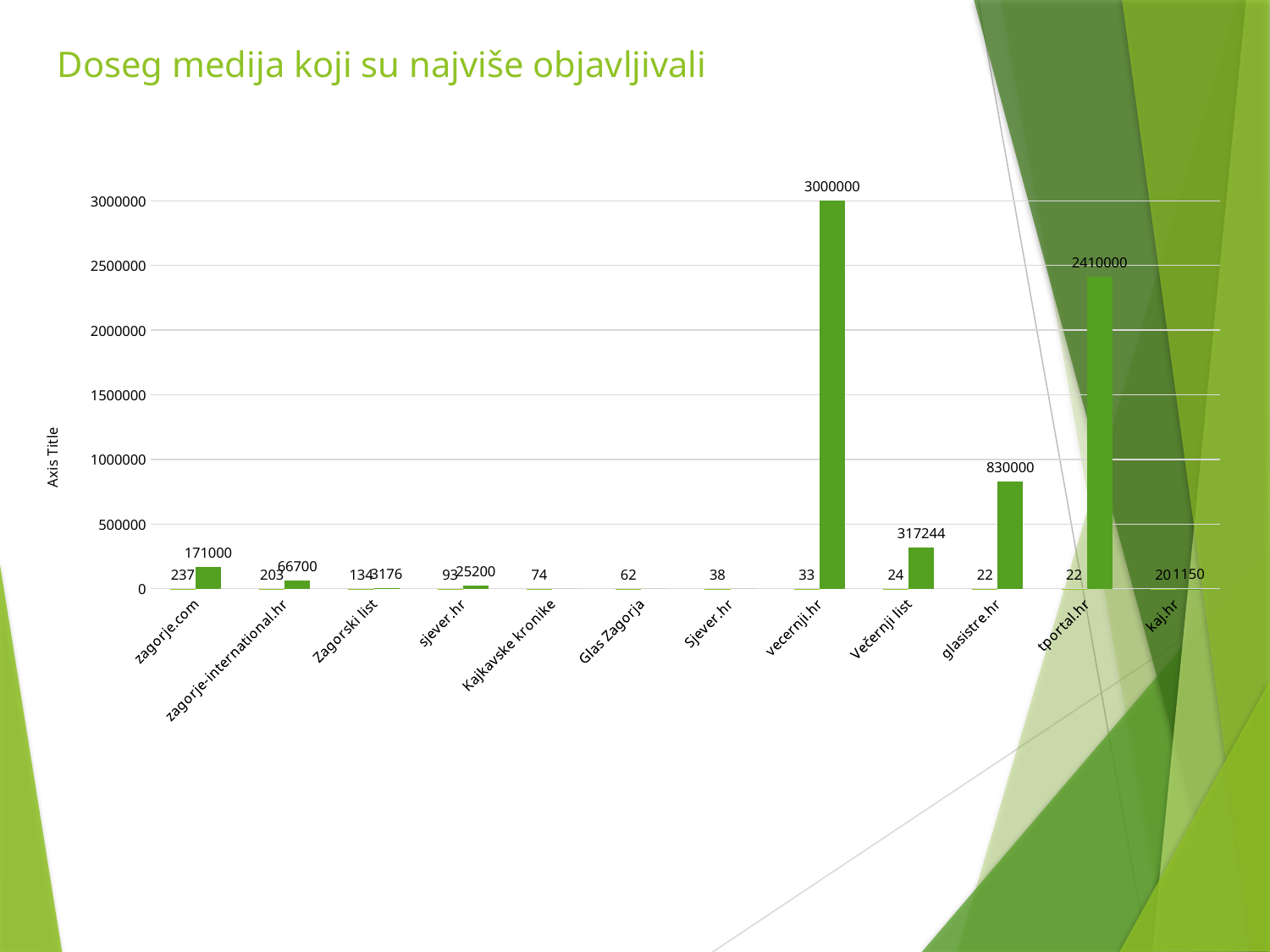
Is the value of the tall bar for glasistre.hr greater or less than 1000000? less What is the value labelled on the tall bar for Večernji list? 317244 What is the title of the chart? Doseg medija koji su najviše objavljivali Which category has the tallest bar on the chart? vecernji.hr Which has the taller bar, glasistre.hr or Večernji list? glasistre.hr What is the value labelled on the tall bar for glasistre.hr? 830000 What is the label on the vertical axis of the chart? Axis Title What is the difference between the tall bar values for vecernji.hr (3000000) and tportal.hr (2410000)? 590000 What is the value labelled on the tallest bar, for vecernji.hr? 3000000 How many categories are shown along the x axis of the chart? 12 What is the value labelled on the tall bar for tportal.hr? 2410000 What kind of chart is shown on the slide? bar chart